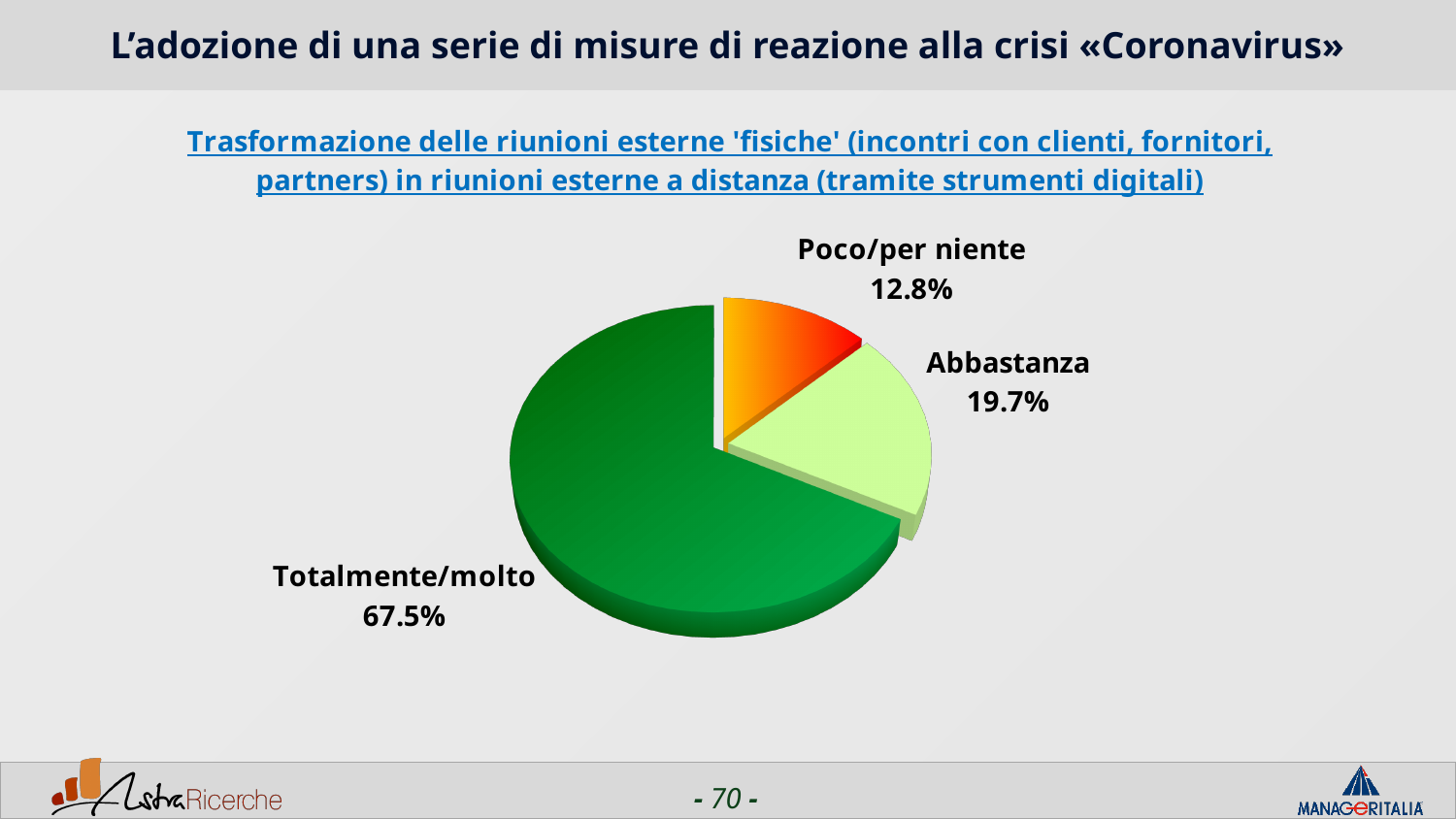
How many slices does the pie chart have? 3 What percentage is shown for 'Abbastanza'? 19.7% What kind of chart is shown on the slide? pie chart What percentage is shown for 'Poco/per niente'? 12.8% What percentage is shown for 'Totalmente/molto'? 67.5% What colour is the 'Totalmente/molto' slice? green What is the difference in percentage points between 'Totalmente/molto' and 'Abbastanza'? 47.8 Which category has the largest share of the pie? Totalmente/molto Which is larger, the share for 'Abbastanza' or the share for 'Poco/per niente'? Abbastanza Which category has the smallest share of the pie? Poco/per niente What is the title of the chart? Trasformazione delle riunioni esterne 'fisiche' (incontri con clienti, fornitori, partners) in riunioni esterne a distanza (tramite strumenti digitali) What is the difference in percentage points between 'Abbastanza' and 'Poco/per niente'? 6.9